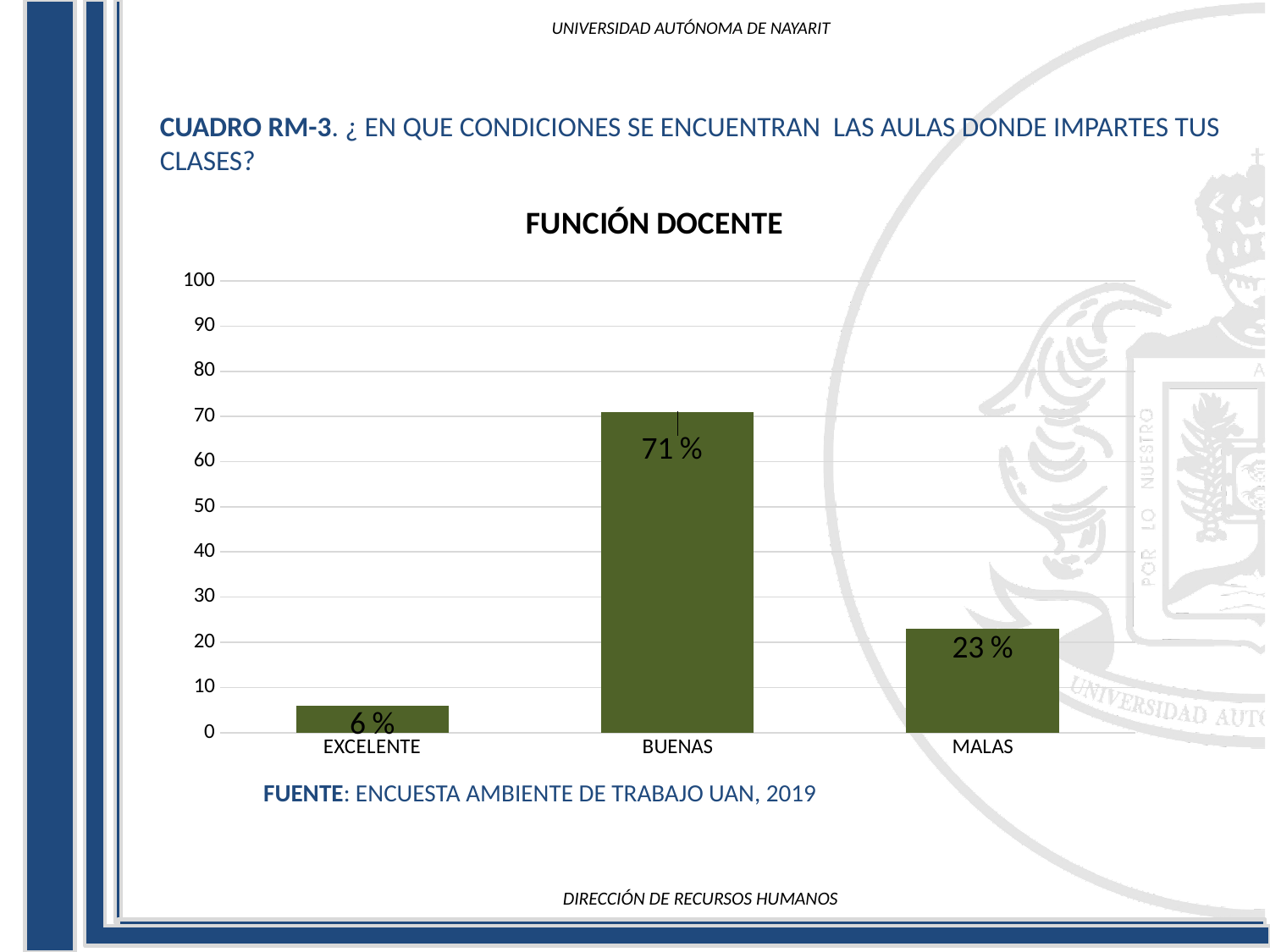
Is the value for BUENAS greater or less than 50? greater What is the title of the chart? FUNCIÓN DOCENTE What is the value for BUENAS? 71 % Which category has the lowest value? EXCELENTE What is the value for MALAS? 23 % What is the value for EXCELENTE? 6 % Which category has the highest value? BUENAS Which is larger, the value for MALAS or the value for EXCELENTE? MALAS What is the difference between the values for MALAS and EXCELENTE? 17 % How many categories are shown on the x axis? 3 What kind of chart is shown on the slide? bar chart What is the difference between the values for BUENAS and MALAS? 48 %